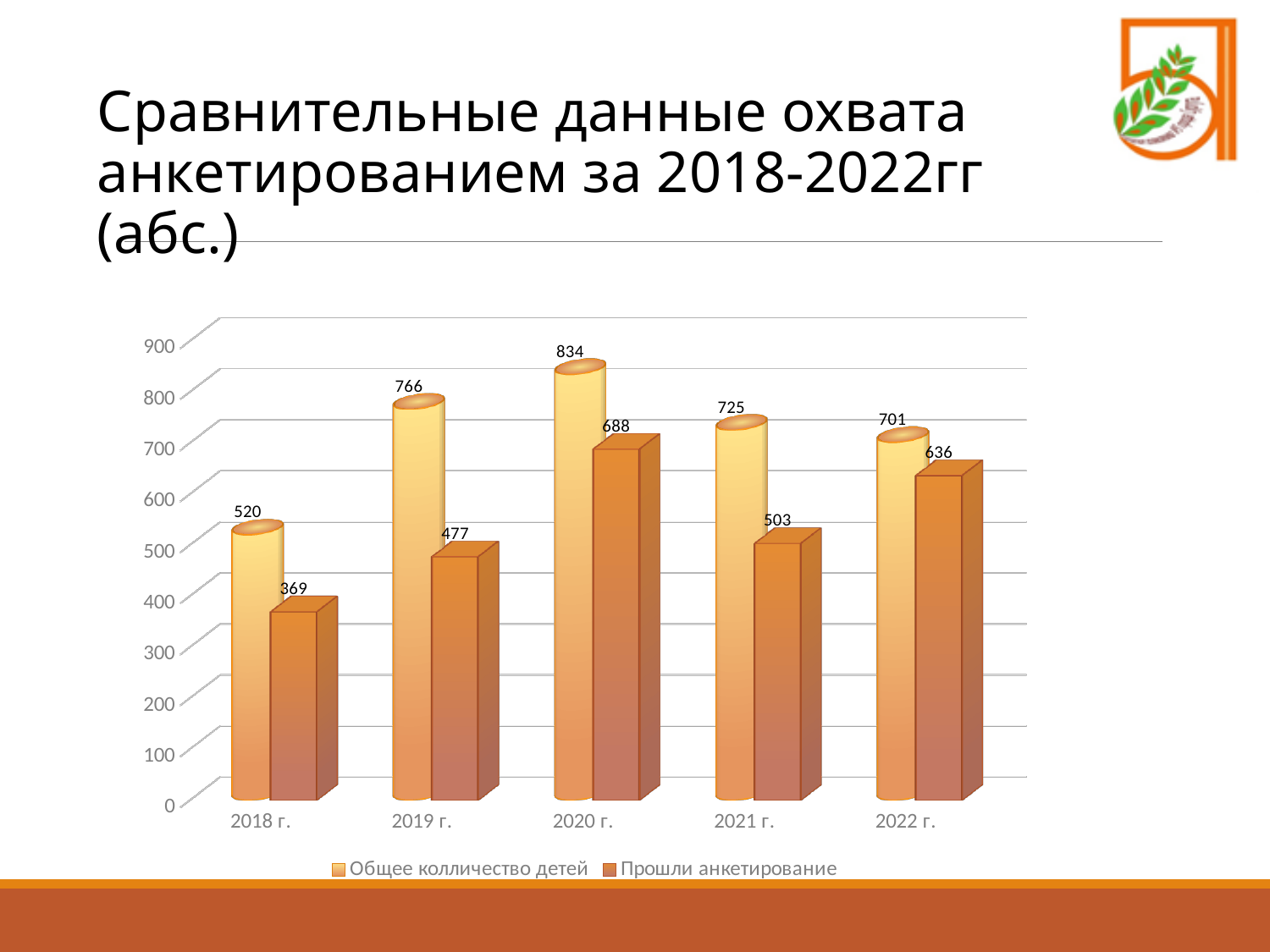
Is the value for 'Общее колличество детей' in 2019 г. greater or less than 700? greater Which is larger: 'Прошли анкетирование' in 2019 г. or in 2021 г.? 2021 г. What is the value of 'Прошли анкетирование' for 2022 г.? 636 What is the difference between 'Общее колличество детей' and 'Прошли анкетирование' in 2021 г.? 222 Does 'Прошли анкетирование' rise or fall from 2018 г. to 2020 г.? Rise Which year has the lowest value for 'Прошли анкетирование'? 2018 г. How many years are shown on the x axis? 5 How many series does the legend list? 2 What kind of chart is shown on the slide? Bar chart What is the value of 'Прошли анкетирование' for 2018 г.? 369 What is the value of 'Общее колличество детей' for 2020 г.? 834 Which year has the highest value for 'Общее колличество детей'? 2020 г.